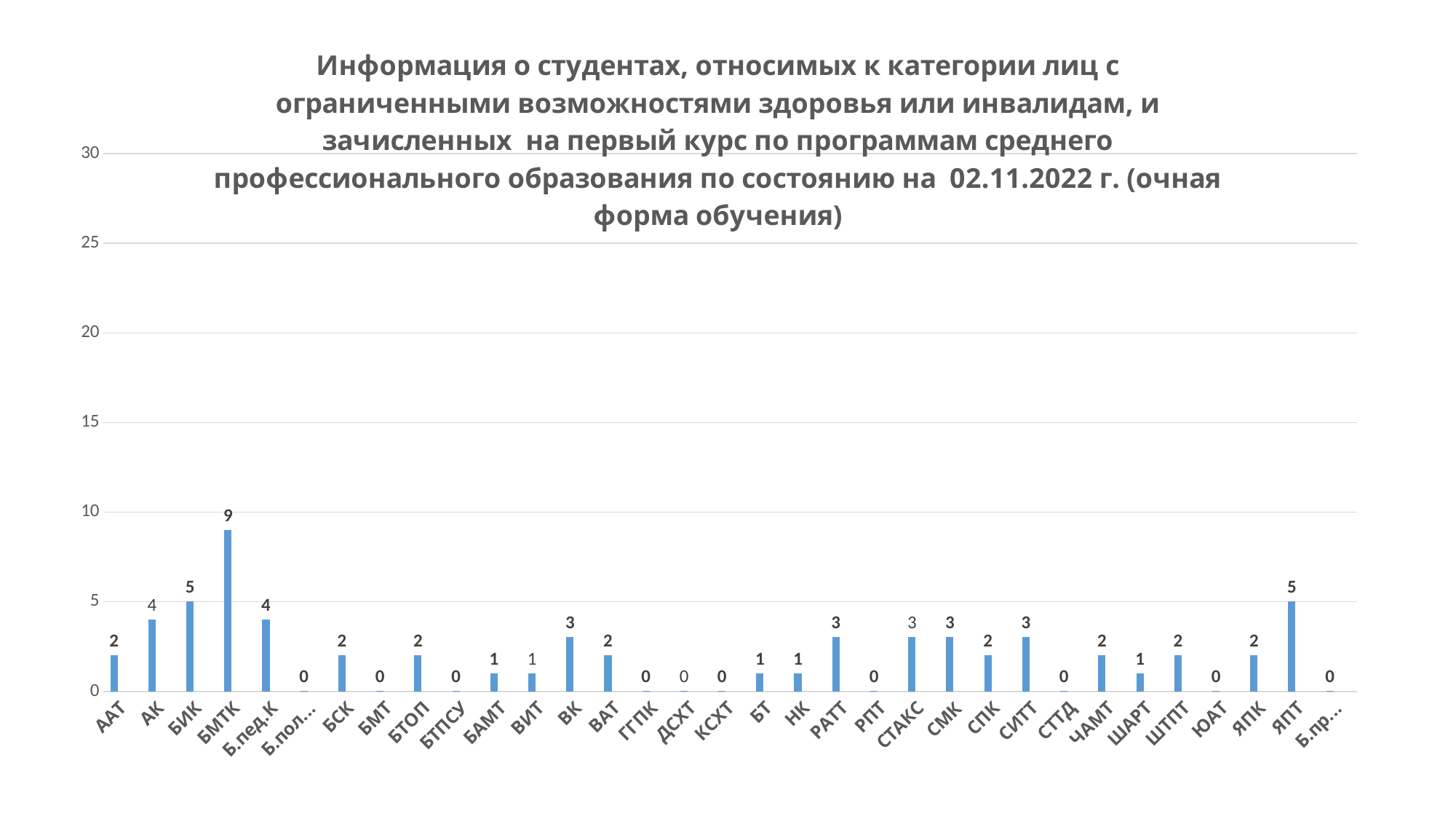
How many categories are shown on the x axis? 33 Which category has the highest value? БМТК What date is given in the chart title? 02.11.2022 г. What kind of chart is shown on the slide? bar chart What is the value for БМТК? 9 What is the value for РАТТ? 3 What is the difference between the values for ЯПТ and ЯПК? 3 Is the value for БМТК greater or less than 10? less What is the value for ЯПТ? 5 Which is larger, the value for АК or the value for ВК? АК What is the value for ЮАТ? 0 What is the difference between the values for БМТК and БИК? 4